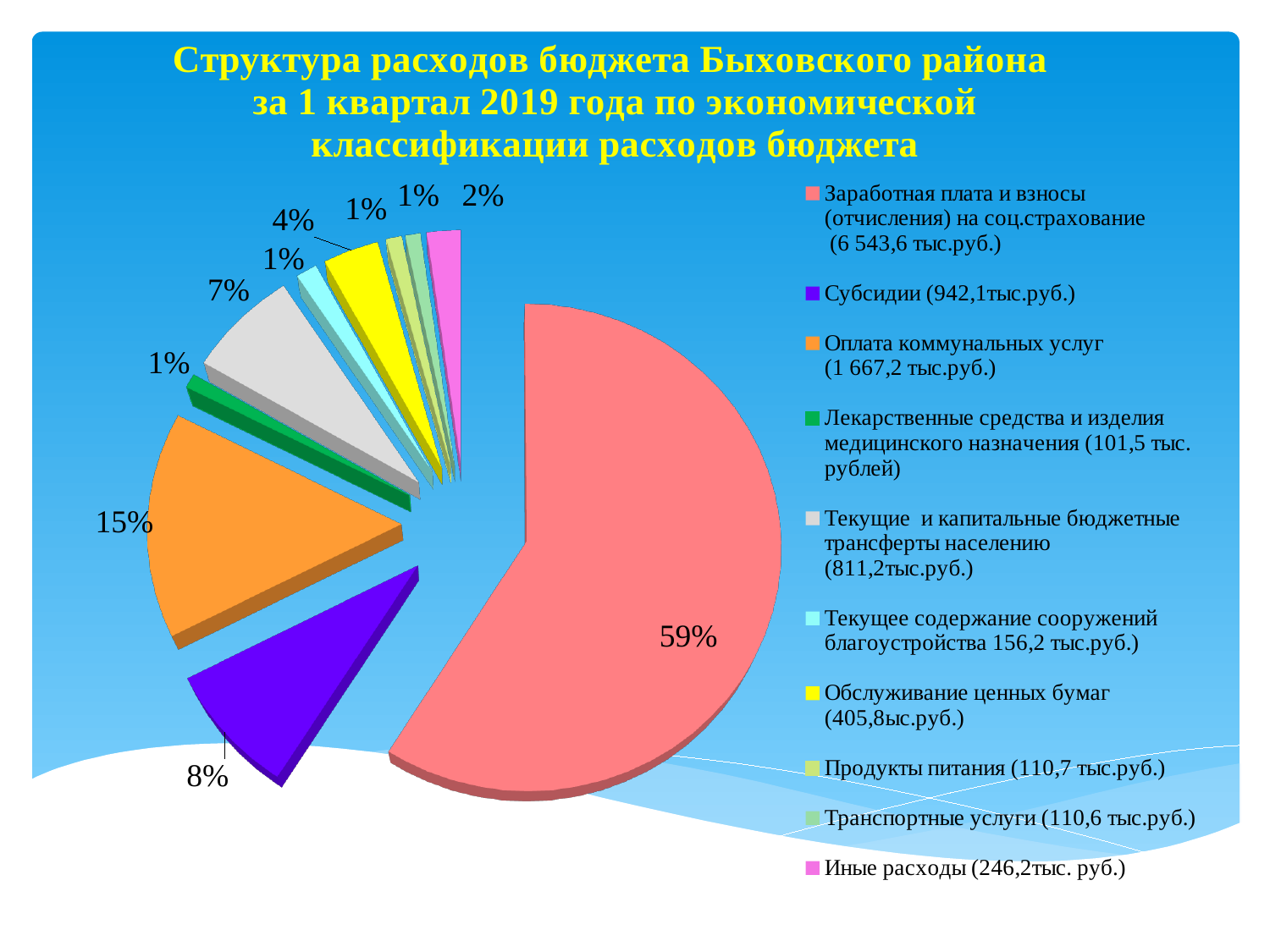
What share of the pie does "Текущие и капитальные бюджетные трансферты населению" take? 7% What share of the pie does "Субсидии" take? 8% What share of the pie does "Обслуживание ценных бумаг" take? 4% Which slice is larger: "Оплата коммунальных услуг" or "Субсидии"? Оплата коммунальных услуг What amount is given in the legend for "Субсидии"? 942,1тыс.руб. How many categories does the legend list? 10 What amount is given in the legend for "Иные расходы"? 246,2тыс. руб. Which category has the largest slice of the pie? Заработная плата и взносы (отчисления) на соц.страхование What kind of chart is shown on the slide? pie chart By how many percentage points does the share of "Заработная плата и взносы (отчисления) на соц.страхование" exceed the share of "Оплата коммунальных услуг"? 44